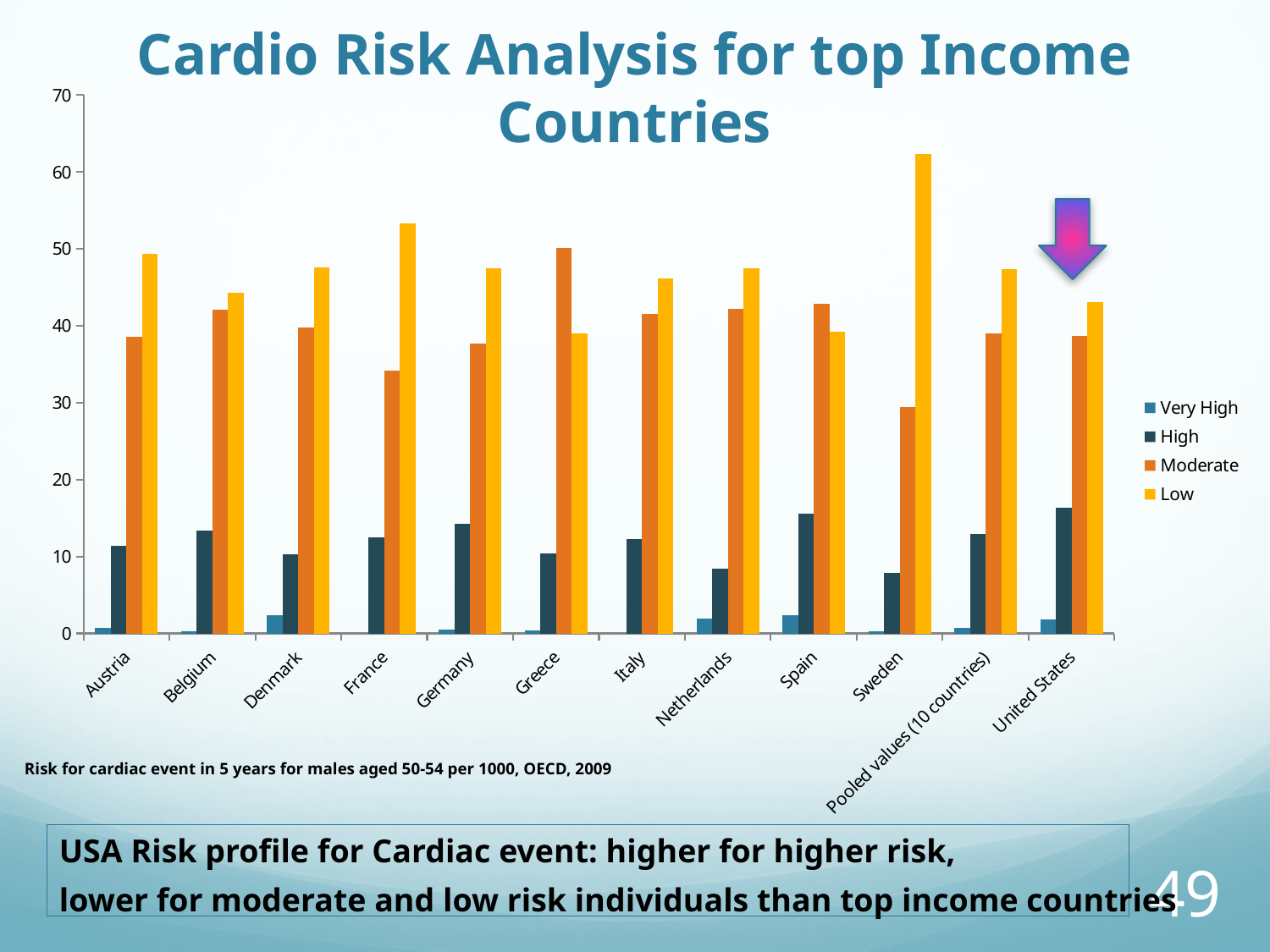
Is the Low value for France greater or less than 50? greater Which category has the lowest Moderate value? Sweden For Greece, which is larger: the Moderate value or the Low value? Moderate How many countries/categories are shown on the x axis? 12 What kind of chart is shown on the slide? bar chart What is the title of the chart? Cardio Risk Analysis for top Income Countries Is the Low value for Sweden greater or less than 60? greater Which category has the highest Low value? Sweden Which category has the highest Moderate value? Greece How many series does the legend list? 4 Is the High value for United States greater or less than 10? greater